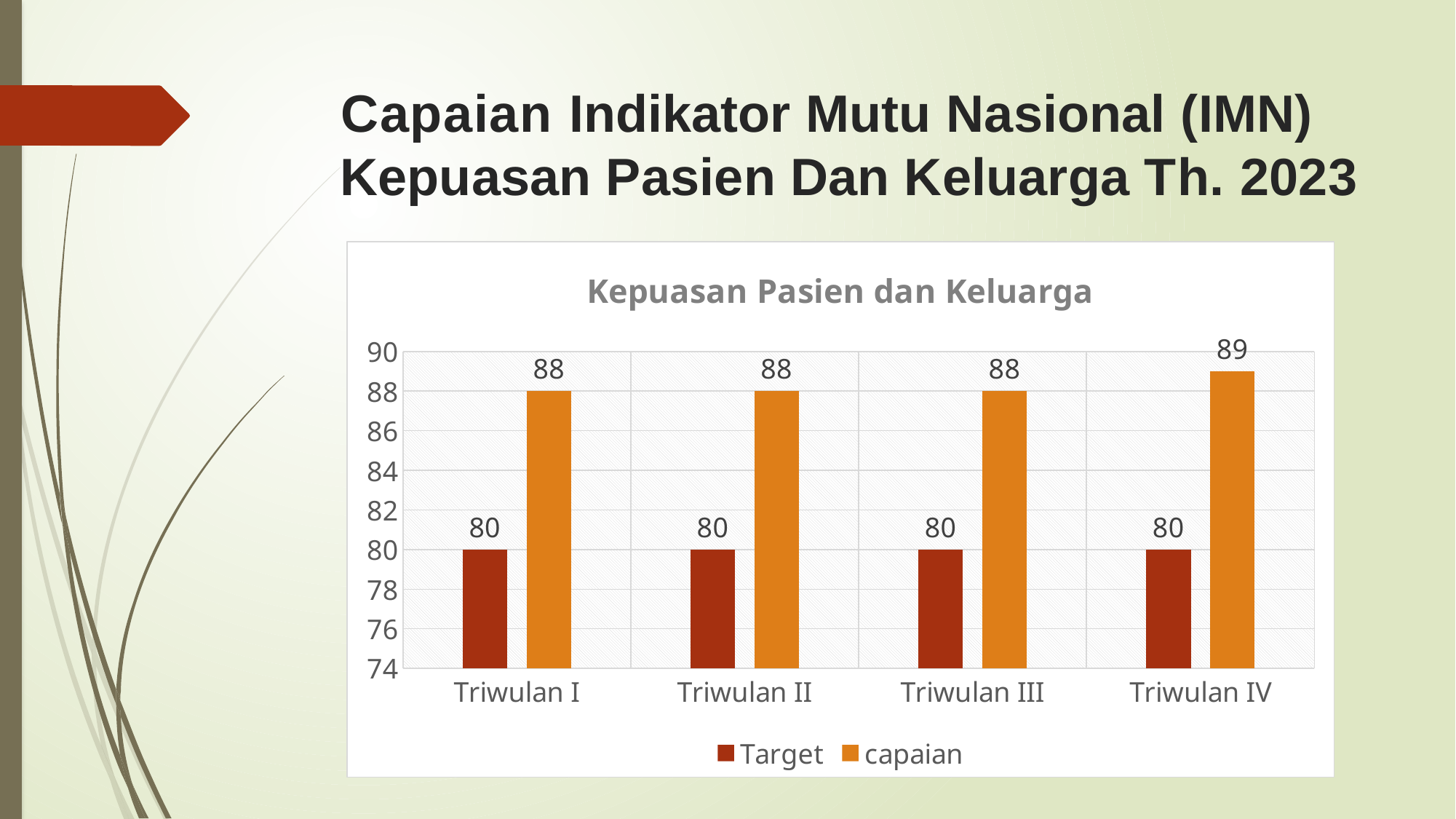
What is the title of the chart? Kepuasan Pasien dan Keluarga Which is larger in Triwulan II, Target or capaian? capaian What is the Target value for Triwulan II? 80 Which quarter has the highest capaian value? Triwulan IV How many series does the legend list? 2 How many quarters (categories) are shown on the x axis? 4 Does the Target value change across the four quarters? No, it stays at 80 What is the capaian value for Triwulan IV? 89 What kind of chart is shown on the slide? bar chart What is the capaian value for Triwulan I? 88 What is the difference between capaian and Target in Triwulan III? 8 What is the difference between the capaian values for Triwulan IV and Triwulan I? 1